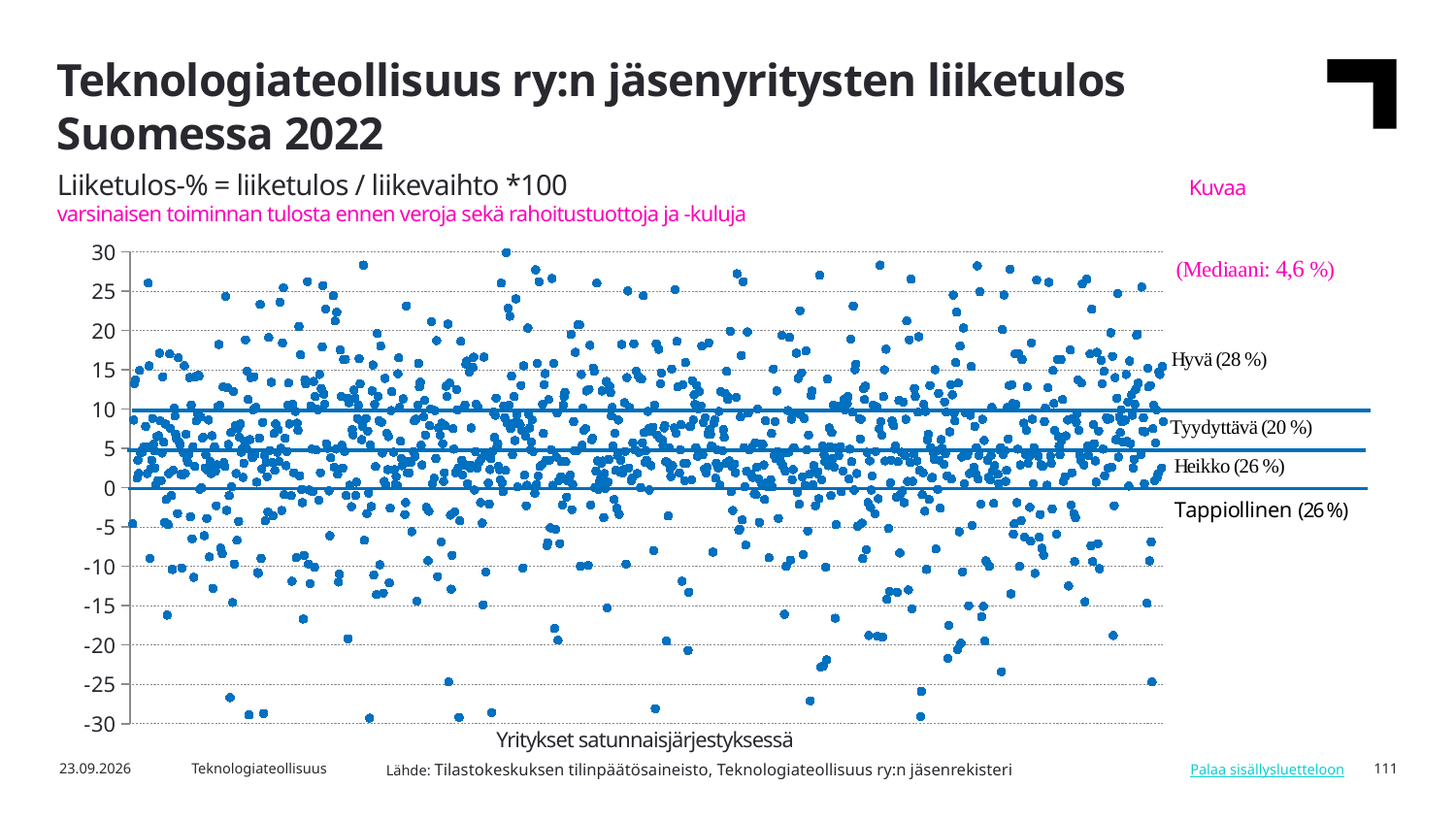
What is the median operating profit percentage (Mediaani) shown on the chart? 4,6 % Which of the four groups (Hyvä, Tyydyttävä, Heikko, Tappiollinen) has the smallest share of companies? Tyydyttävä How many profitability groups are labelled on the chart? 4 What share of companies falls into the Hyvä group? 28 % Which of the four groups (Hyvä, Tyydyttävä, Heikko, Tappiollinen) has the largest share of companies? Hyvä What share of companies falls into the Tappiollinen group? 26 % Which group has a larger share of companies, Hyvä or Heikko? Hyvä What share of companies falls into the Heikko group? 26 % What is the label of the x axis of the chart? Yritykset satunnaisjärjestyksessä What share of companies falls into the Tyydyttävä group? 20 % What kind of chart is shown on the slide? Scatter chart What is the difference in percentage points between the Hyvä share and the Tyydyttävä share? 8